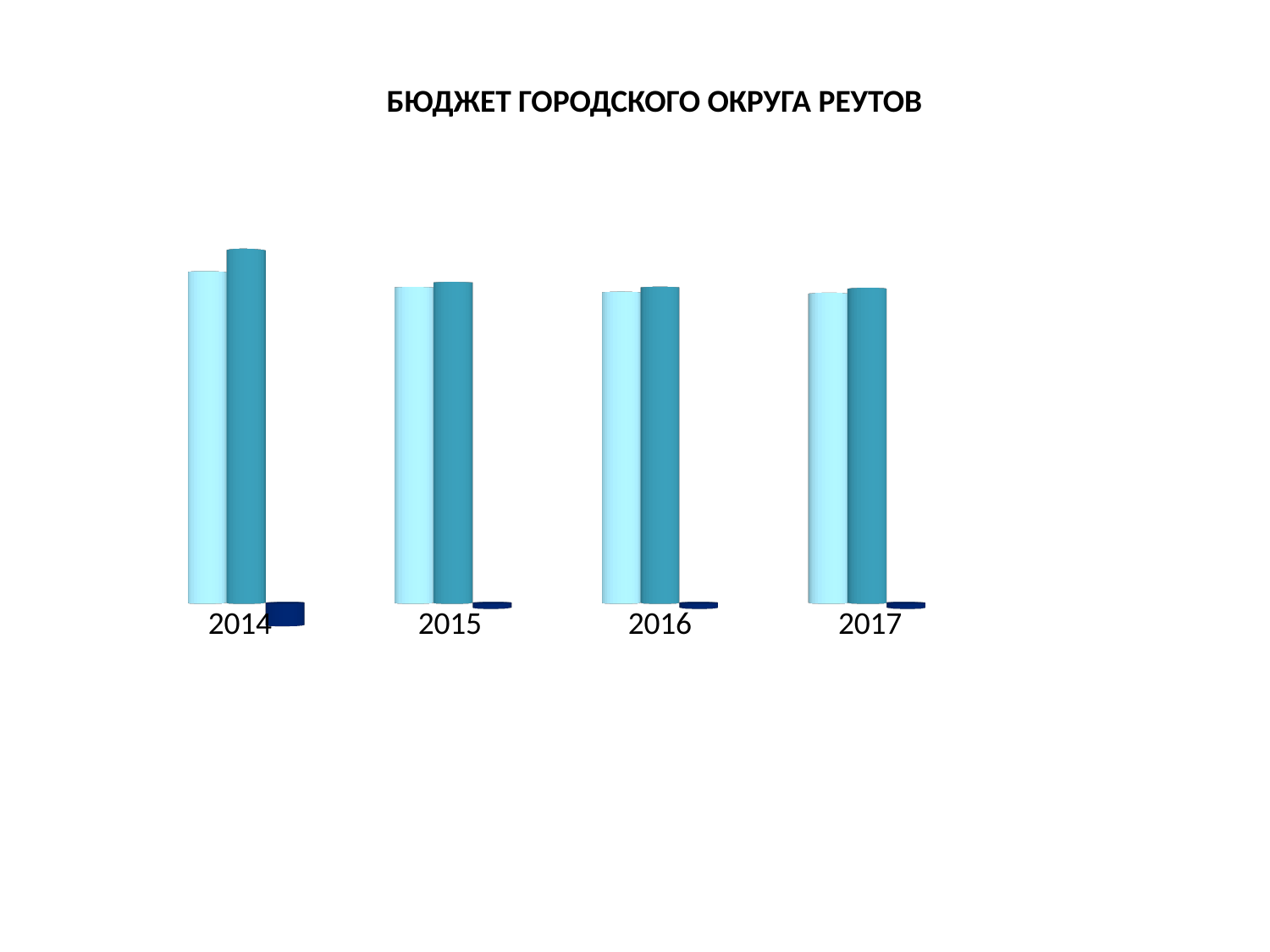
What is the title of the chart? БЮДЖЕТ ГОРОДСКОГО ОКРУГА РЕУТОВ In which year is the light blue (first) bar the tallest? 2014 Is the teal bar for 2014 taller or shorter than the teal bar for 2015? Taller What kind of chart is shown on the slide? Bar chart How many years are shown on the x axis of the chart? 4 Which years are shown as categories on the x axis? 2014, 2015, 2016, 2017 In which year does the dark navy (third) bar extend below the baseline most noticeably? 2014 Do the teal bars rise or fall from 2014 to 2017? Fall In which year is the teal (middle) bar the tallest? 2014 In 2014, which bar is taller: the light blue bar or the teal bar? The teal bar Is the light blue bar for 2014 taller or shorter than the light blue bar for 2017? Taller How many bars are plotted for each year? 3